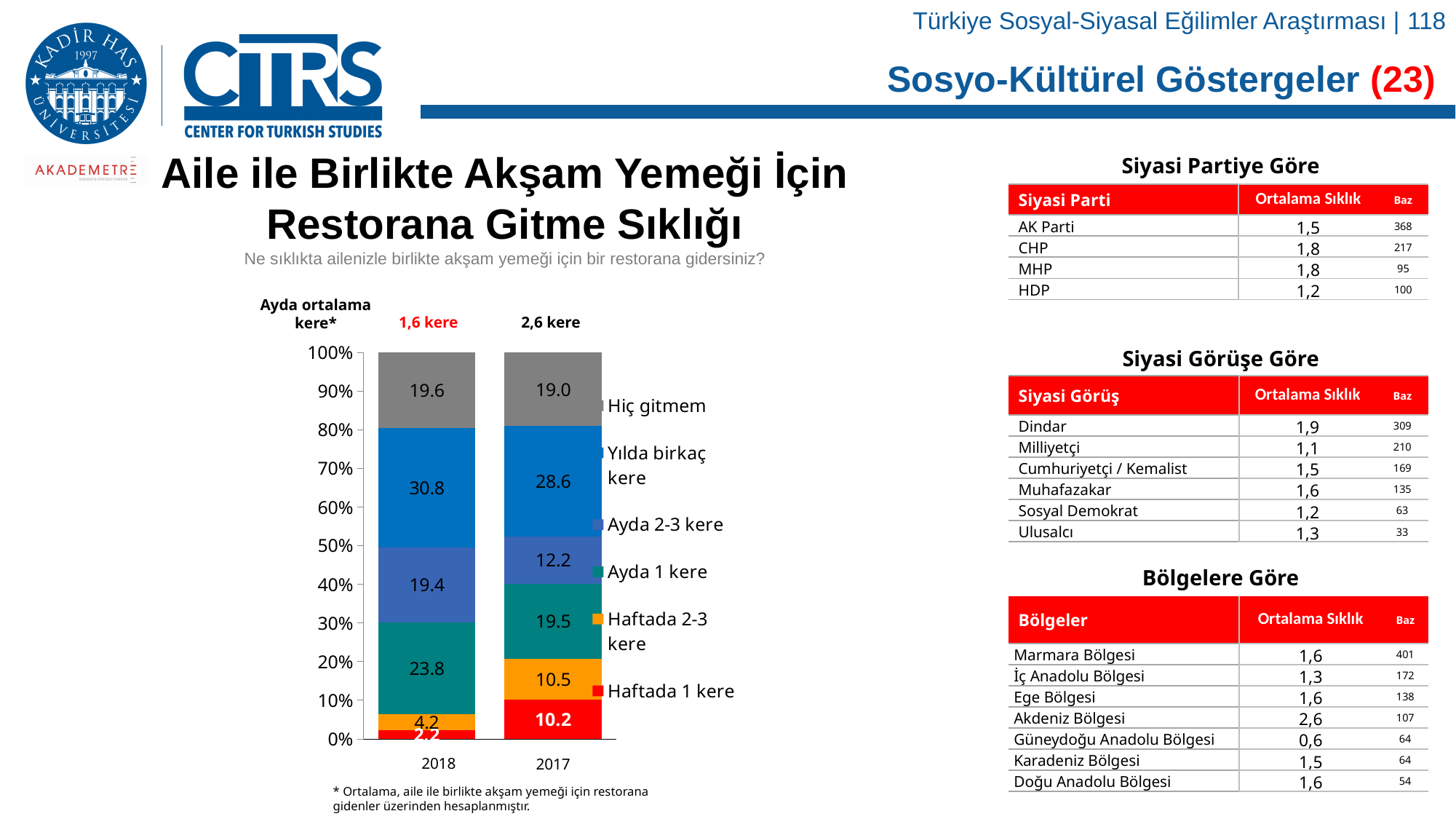
What average monthly frequency ('Ayda ortalama kere') is shown above the 2018 bar? 1,6 kere What is the value for 'Ayda 2-3 kere' in 2018? 19.4 Is the 'Haftada 2-3 kere' value larger in 2018 or 2017? 2017 How many series does the chart legend list? 6 How many bars (years) are shown in the chart? 2 What is the value for 'Haftada 1 kere' in 2017? 10.2 What is the difference between the 'Yılda birkaç kere' values for 2018 and 2017? 2.2 Which category has the largest share in the 2018 bar? Yılda birkaç kere What kind of chart is shown on the slide? Stacked bar chart Which category has the smallest share in the 2018 bar? Haftada 1 kere What is the value for 'Ayda 1 kere' in 2017? 19.5 What is the value for 'Hiç gitmem' in 2018? 19.6